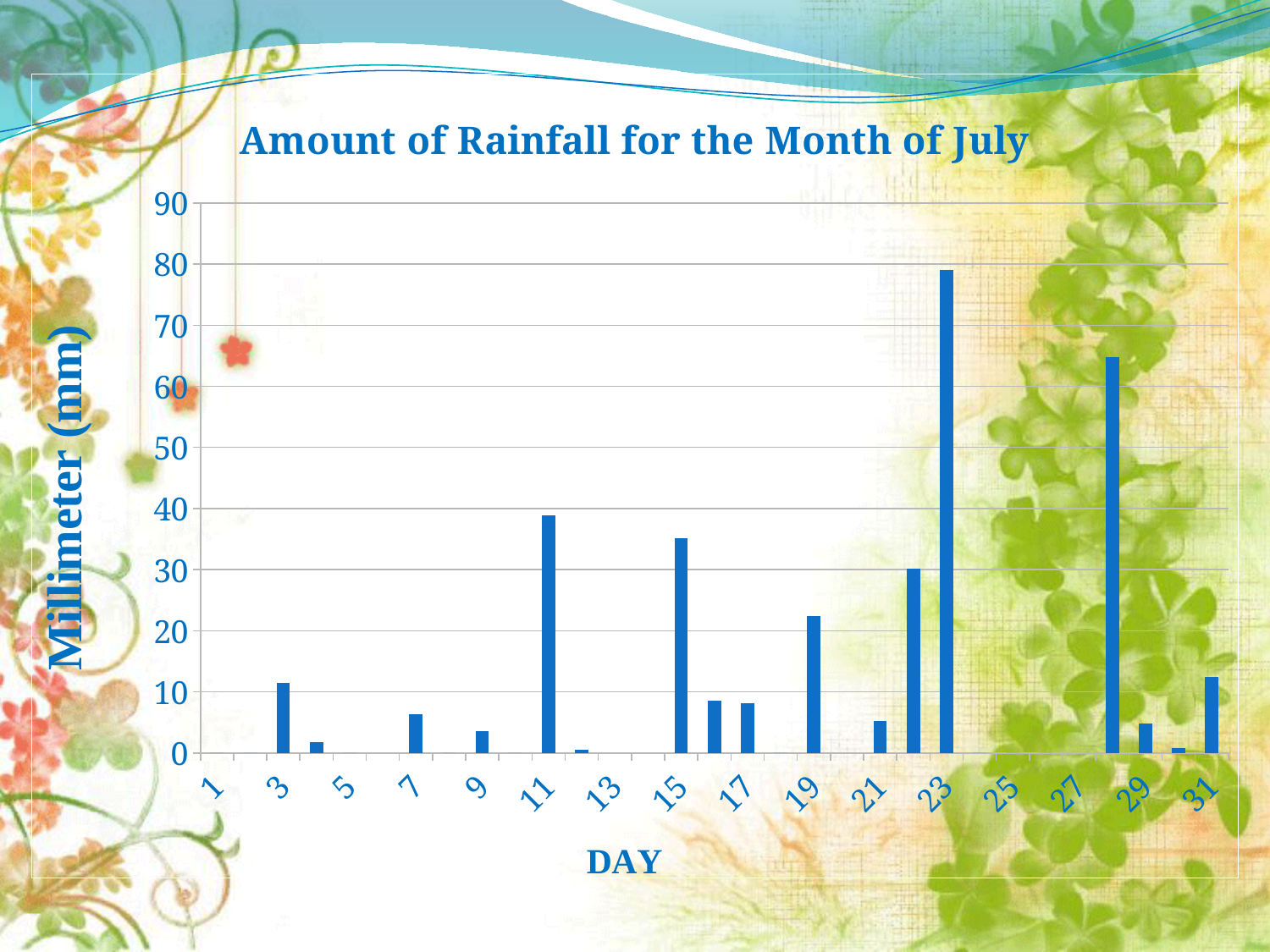
Is the rainfall value for day 3 greater or less than 20? less Which day has more rainfall, day 23 or day 28? 23 What is the label on the vertical axis of the chart? Millimeter (mm) What kind of chart is shown on the slide? bar chart Is the rainfall value for day 15 greater or less than 30? greater What is the title of the chart? Amount of Rainfall for the Month of July Which day has more rainfall, day 11 or day 15? 11 Is the rainfall value for day 11 greater or less than 40? less Which day has the highest rainfall in the chart? 23